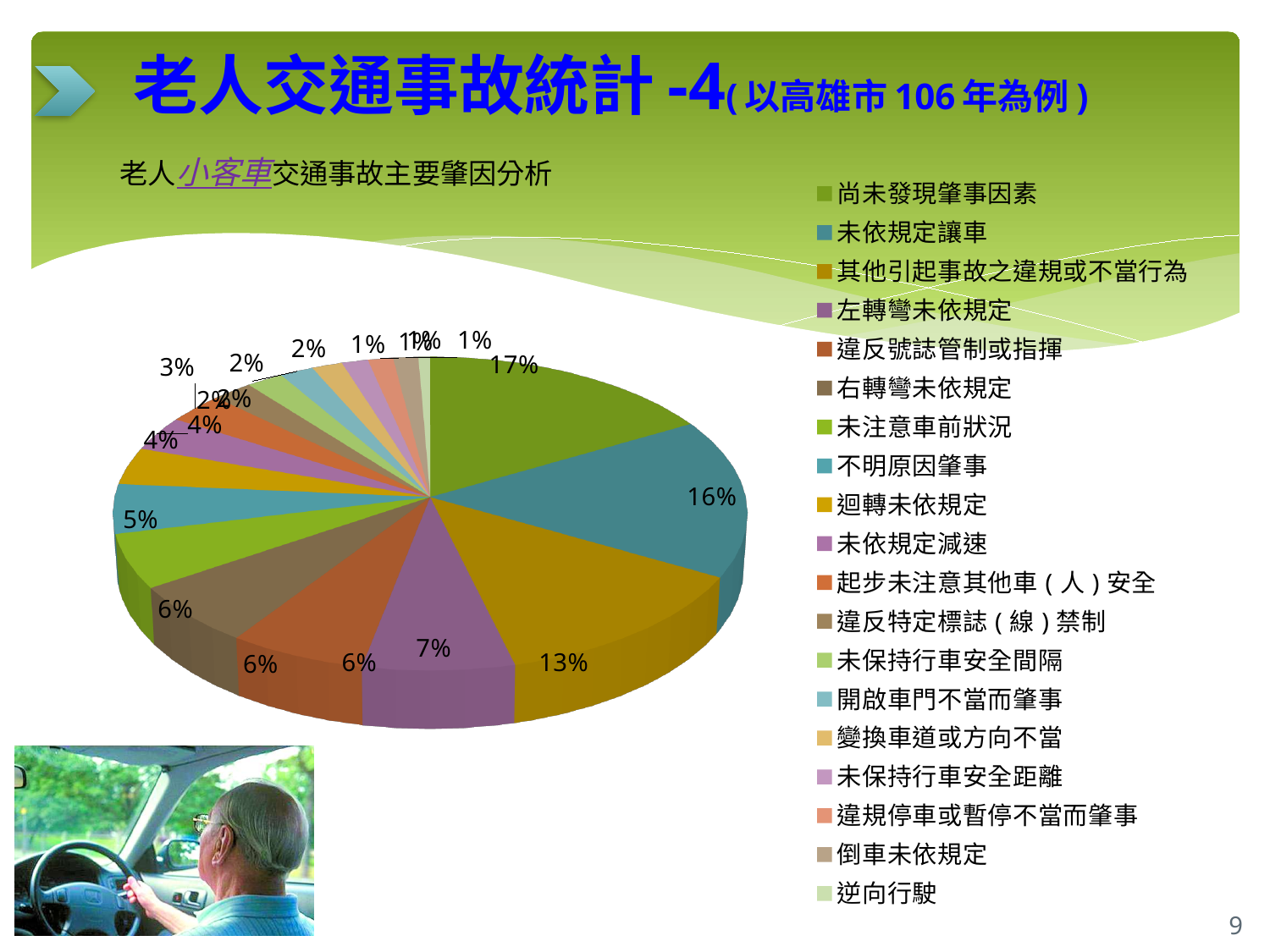
How many categories does the legend list? 19 Which category has the largest share of the pie? 尚未發現肇事因素 Which category is listed last in the legend? 逆向行駛 What kind of chart is shown on the slide? pie chart Which is larger, the share for 其他引起事故之違規或不當行為 or the share for 左轉彎未依規定? 其他引起事故之違規或不當行為 What is the subtitle describing the chart? 老人小客車交通事故主要肇因分析 What share of the pie does 其他引起事故之違規或不當行為 have? 13% What share of the pie does 左轉彎未依規定 have? 7% What share of the pie does 尚未發現肇事因素 have? 17% What is the difference in percentage points between 尚未發現肇事因素 and 未依規定讓車? 1